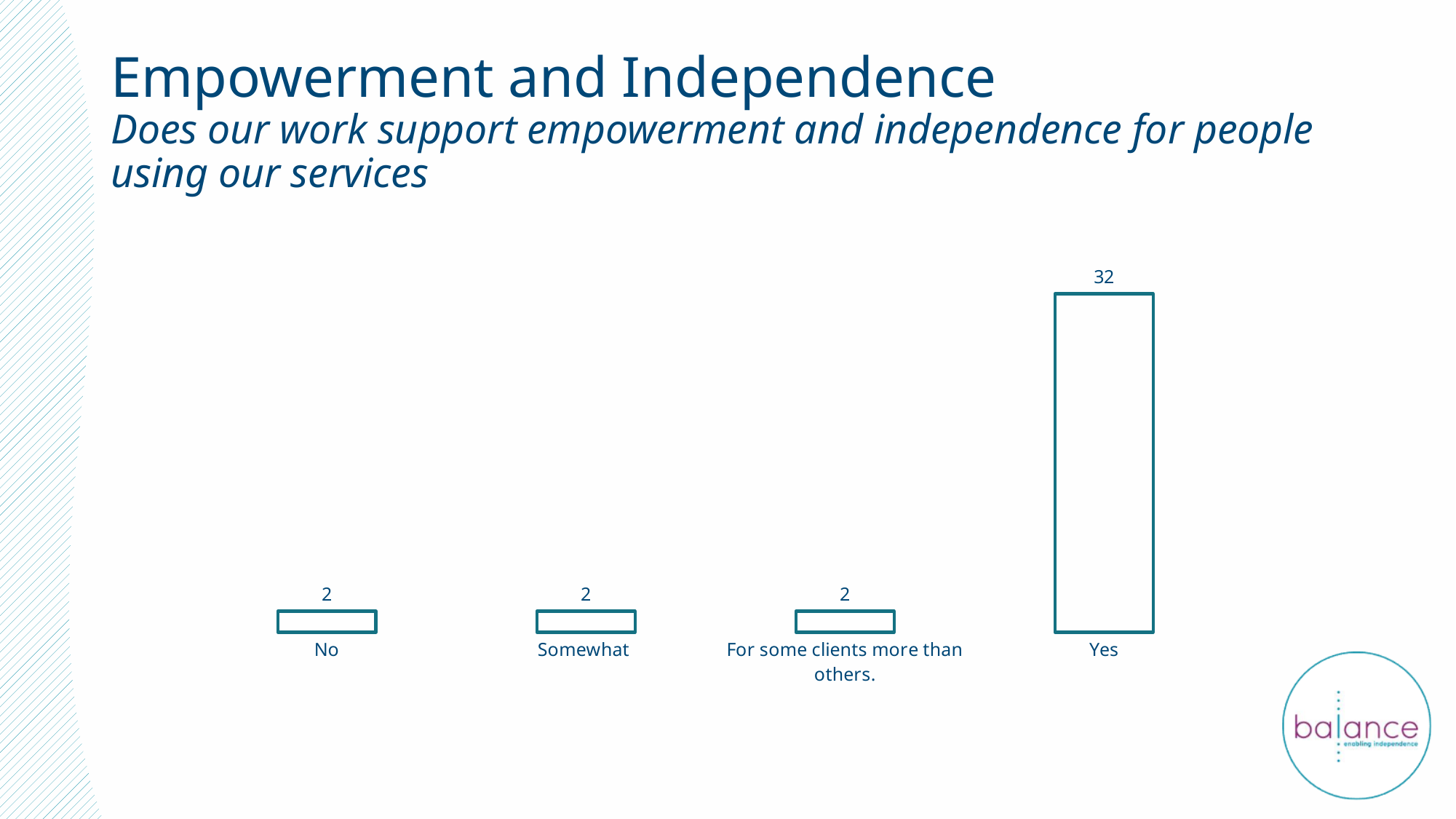
How many categories are shown in the chart? 4 What is the title of the slide containing the chart? Empowerment and Independence Which is larger, the value for "Yes" or the value for "Somewhat"? Yes What kind of chart is shown on the slide? Bar chart What is the value for "Yes"? 32 What is the value for "For some clients more than others."? 2 What is the value for "No"? 2 How many categories have a value of 2? 3 What is the total of all four values in the chart? 38 What is the difference between the values for "Yes" and "No"? 30 What is the value for "Somewhat"? 2 Which category has the highest value? Yes